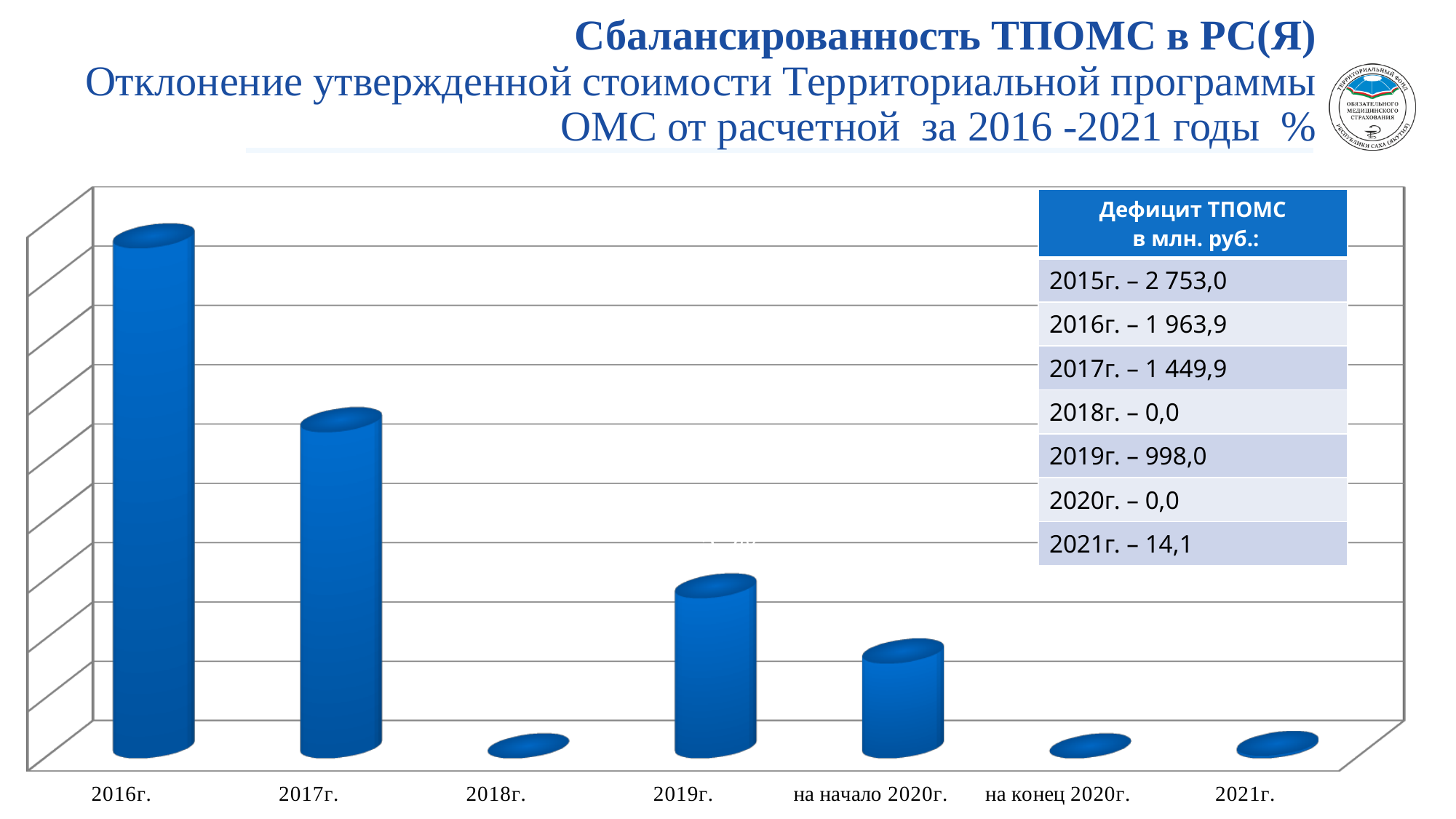
Which is larger in the chart, the value for 2017г. or the value for 2019г.? 2017г. Which is larger in the chart, the value for 2019г. or the value for на начало 2020г.? 2019г. What kind of chart is shown on the slide? bar chart How many categories are shown along the x axis of the chart? 7 What colour are the bars in the chart? blue Do the bar values generally rise or fall from 2016г. to 2021г. along the x axis? fall What is the label of the fifth category on the x axis of the chart? на начало 2020г. Which is larger in the chart, the value for 2016г. or the value for 2017г.? 2016г. Which category has the highest bar in the chart? 2016г.